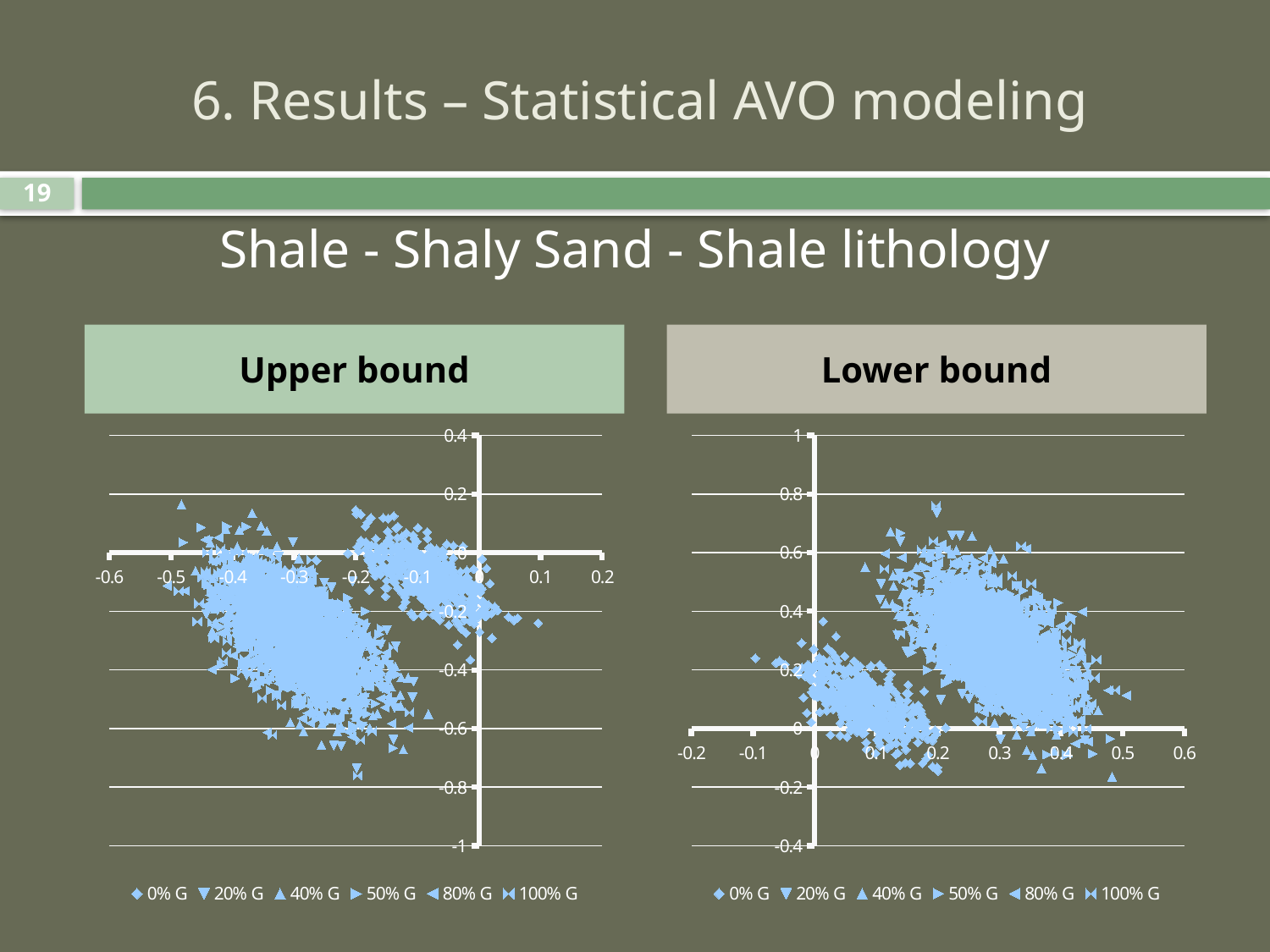
What kind of chart is the Upper bound chart? scatter chart How many series does the legend of the Lower bound chart list? 6 How many series does the legend of the Upper bound chart list? 6 In the Lower bound chart, do the plotted points generally rise or fall as the x value increases? fall In the Upper bound chart, do the plotted points generally rise or fall as the x value increases? fall What is the first series listed in the legend of the Lower bound chart? 0% G How many charts are shown on the slide? 2 What is the last series listed in the legend of the Upper bound chart? 100% G What kind of chart is the Lower bound chart? scatter chart